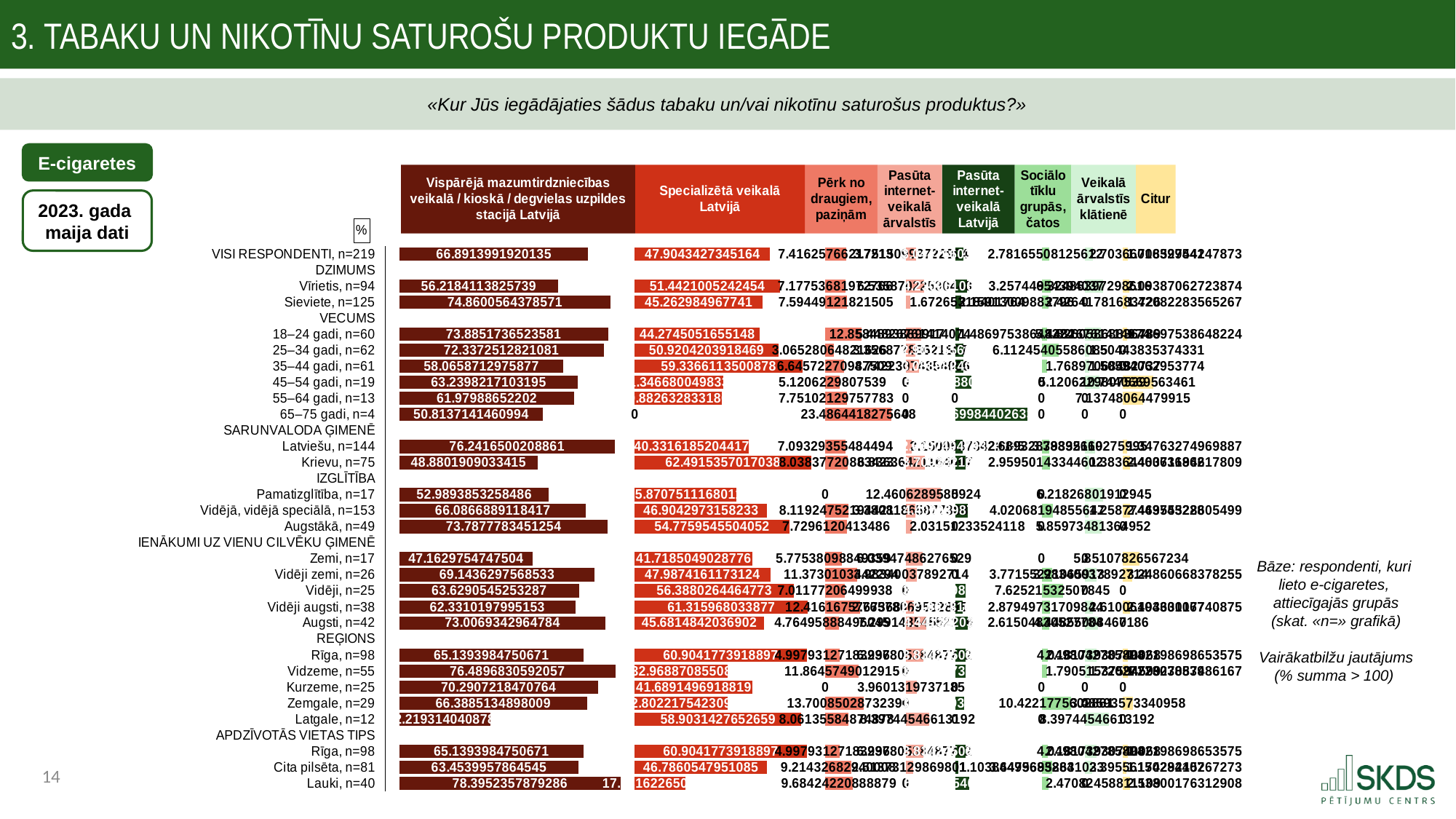
What is the value for Krievu, n=75 in the Specializētā veikalā Latvijā series? 62.4915357017038 What is the value for 65–75 gadi, n=4 in the Specializētā veikalā Latvijā series? 0 In the Vispārējā mazumtirdzniecības veikalā / kioskā / degvielas uzpildes stacijā Latvijā series, which is larger: Vīrietis, n=94 or Sieviete, n=125? Sieviete, n=125 What is the value for Lauki, n=40 in the Vispārējā mazumtirdzniecības veikalā / kioskā / degvielas uzpildes stacijā Latvijā series? 78.3952357879286 Among the REĢIONS categories, which has the highest value in the Vispārējā mazumtirdzniecības veikalā / kioskā / degvielas uzpildes stacijā Latvijā series? Vidzeme, n=55 What is the value for Augstākā, n=49 in the Specializētā veikalā Latvijā series? 54.7759545504052 Among the VECUMS (age) categories, which has the lowest value in the Vispārējā mazumtirdzniecības veikalā / kioskā / degvielas uzpildes stacijā Latvijā series? 65–75 gadi, n=4 Which product does the chart on the slide refer to, according to the green label at the top left? E-cigaretes What kind of chart is shown on the slide? Bar chart What is the difference between Latviešu, n=144 and Krievu, n=75 in the Vispārējā mazumtirdzniecības veikalā / kioskā / degvielas uzpildes stacijā Latvijā series? 27.3614591175446 How many series (purchase places) does the chart header list? 8 What is the value for VISI RESPONDENTI, n=219 in the Vispārējā mazutirdzniecības veikalā / kioskā / degvielas uzpildes stacijā Latvijā series? 66.8913991920135